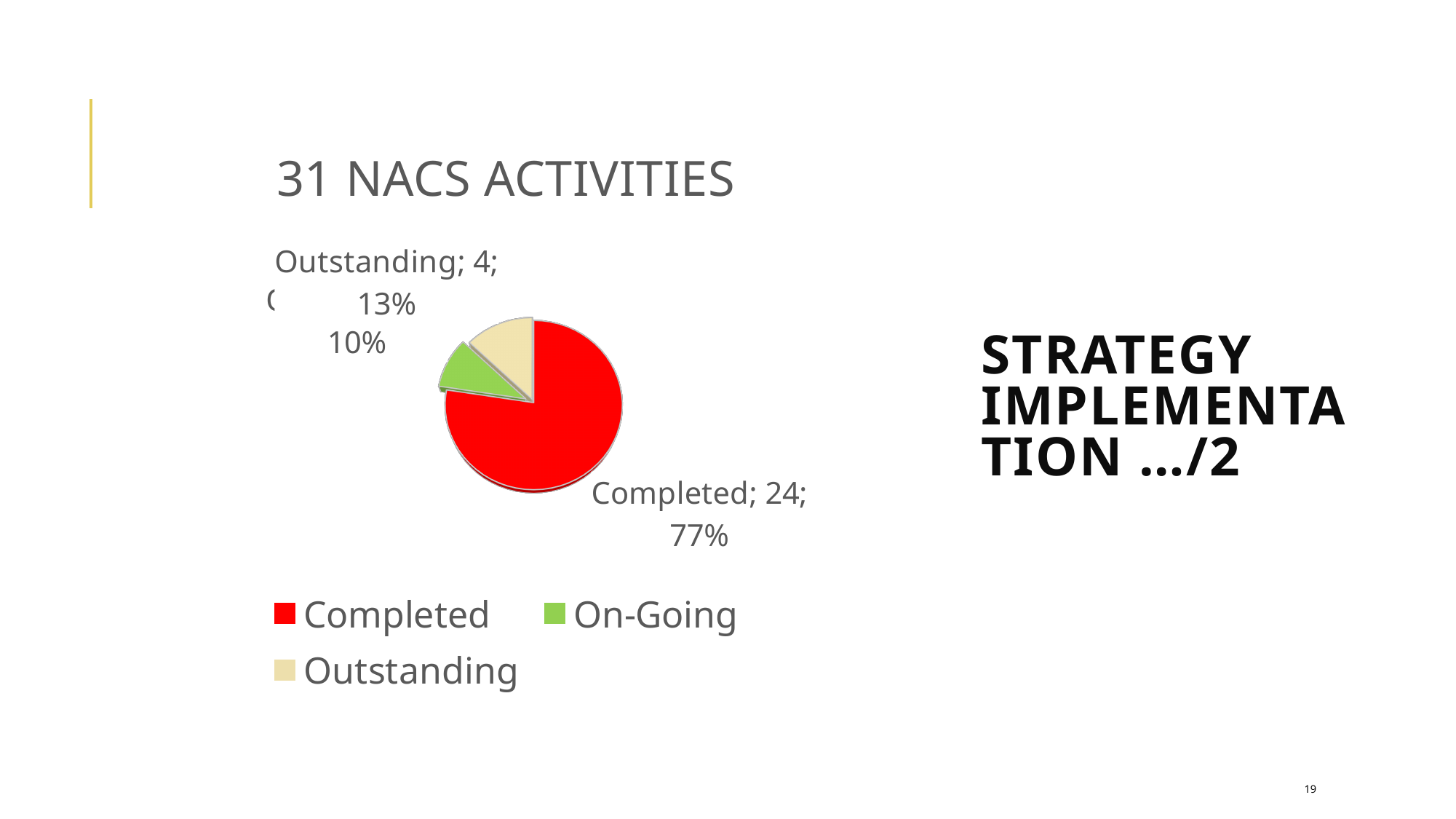
How many activities are shown as Completed in the pie chart? 24 Which category has the largest slice of the pie? Completed How many activities are shown as Outstanding in the pie chart? 4 What colour represents the Completed category in the pie chart? red What percentage share of the pie does the Outstanding slice have? 13% What is the title of the pie chart? 31 NACS ACTIVITIES Which category has the smallest slice of the pie? On-Going How many categories does the legend of the pie chart list? 3 What percentage share of the pie does the On-Going slice have? 10% What percentage share of the pie does the Completed slice have? 77% What type of chart is shown on the slide? pie chart What is the difference between the number of Completed and Outstanding activities? 20